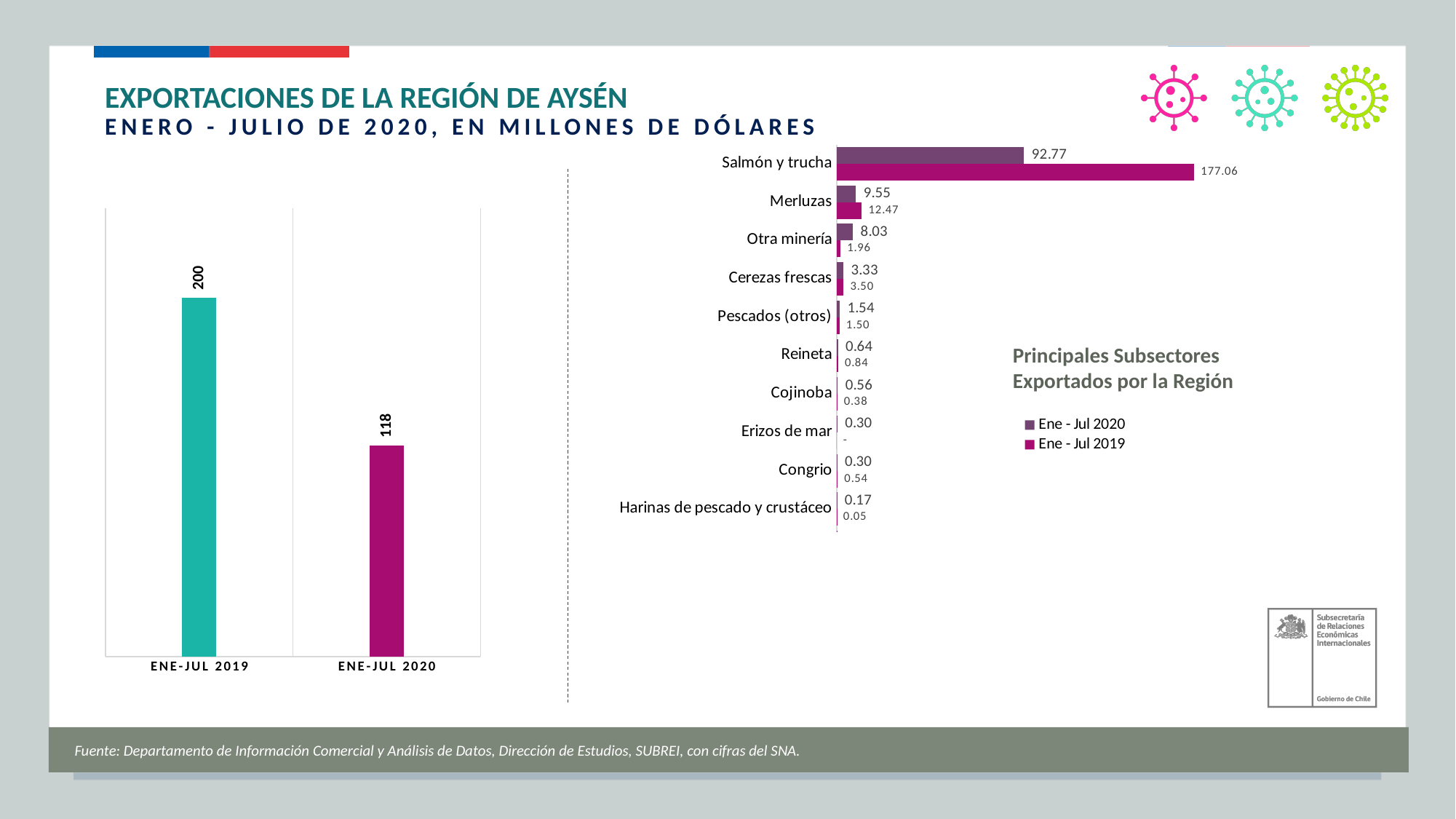
In the 'Principales Subsectores Exportados por la Región' chart, what is the Ene - Jul 2019 value for Merluzas? 12.47 What type of chart is the 'Principales Subsectores Exportados por la Región' chart? Bar chart In the 'Principales Subsectores Exportados por la Región' chart, how many series does the legend list? 2 In the 'Principales Subsectores Exportados por la Región' chart, how many subsectors are listed? 10 In the left bar chart, what is the difference between the ENE-JUL 2019 and ENE-JUL 2020 values? 82 In the 'Principales Subsectores Exportados por la Región' chart, what is the difference between the Ene - Jul 2019 and Ene - Jul 2020 values for Salmón y trucha? 84.29 In the 'Principales Subsectores Exportados por la Región' chart, which subsector has the highest Ene - Jul 2019 value? Salmón y trucha In the 'Principales Subsectores Exportados por la Región' chart, what is the Ene - Jul 2020 value for Salmón y trucha? 92.77 In the left bar chart, which period has the higher value, ENE-JUL 2019 or ENE-JUL 2020? ENE-JUL 2019 In the 'Principales Subsectores Exportados por la Región' chart, what is the Ene - Jul 2020 value for Otra minería? 8.03 In the left bar chart, what is the value for ENE-JUL 2019? 200 In the left bar chart, what is the value for ENE-JUL 2020? 118